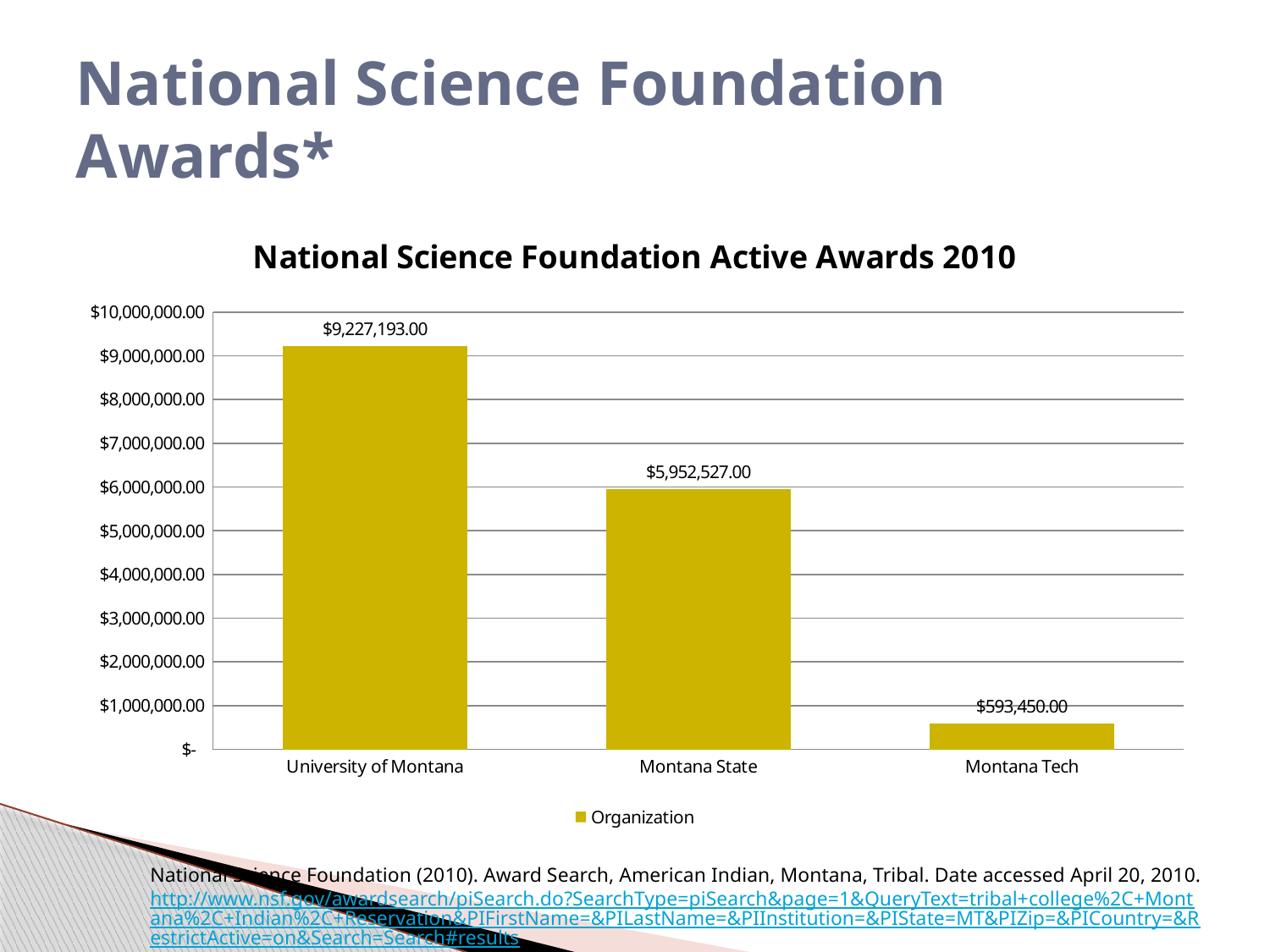
What is the difference between the values for University of Montana and Montana State? $3,274,666.00 What is the value for University of Montana? $9,227,193.00 Which is larger, the value for Montana State or the value for Montana Tech? Montana State Is the value for Montana Tech greater or less than $1,000,000.00? less What is the title of the chart? National Science Foundation Active Awards 2010 Which organization has the lowest value? Montana Tech Which organization has the highest value? University of Montana What kind of chart is shown on the slide? bar chart What is the value for Montana Tech? $593,450.00 How many organizations are shown on the chart? 3 What is the difference between the values for Montana State and Montana Tech? $5,359,077.00 What is the value for Montana State? $5,952,527.00